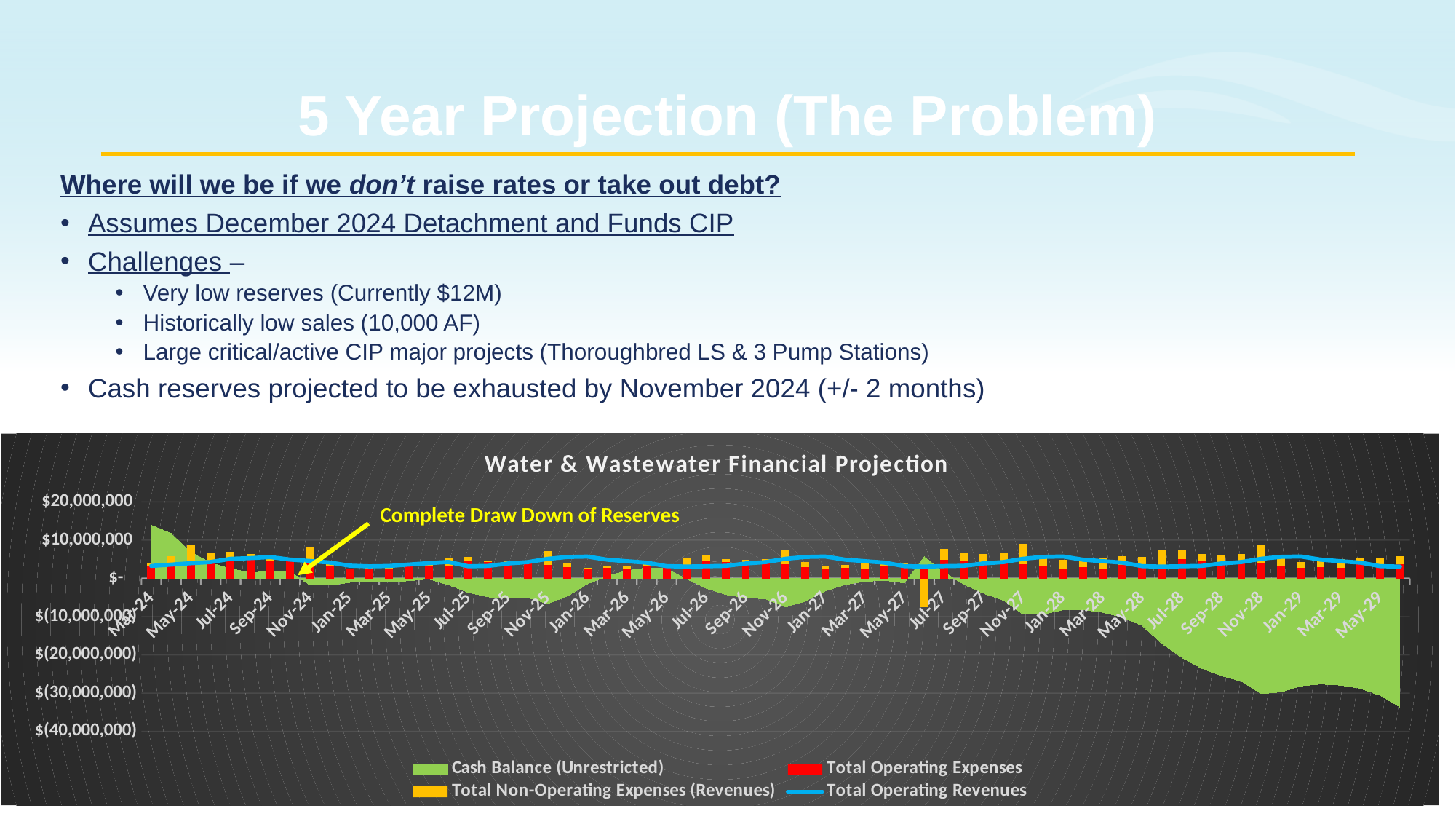
Which is larger, the Cash Balance (Unrestricted) at Mar-24 or at May-29? Mar-24 How many month labels are shown on the chart's x axis? 32 At which x-axis label is the Cash Balance (Unrestricted) lowest? May-29 Is the Cash Balance (Unrestricted) value at Mar-24 greater or less than $10,000,000? greater How many series does the chart legend list? 4 Is the Total Operating Revenues value at Jan-26 greater or less than $10,000,000? less Is the Total Non-Operating Expenses (Revenues) value at Jul-27 greater or less than $-? greater Overall, does the Cash Balance (Unrestricted) rise or fall from Mar-24 to May-29? fall What is the title of the chart on the slide? Water & Wastewater Financial Projection Which series in the chart is drawn as a blue line? Total Operating Revenues